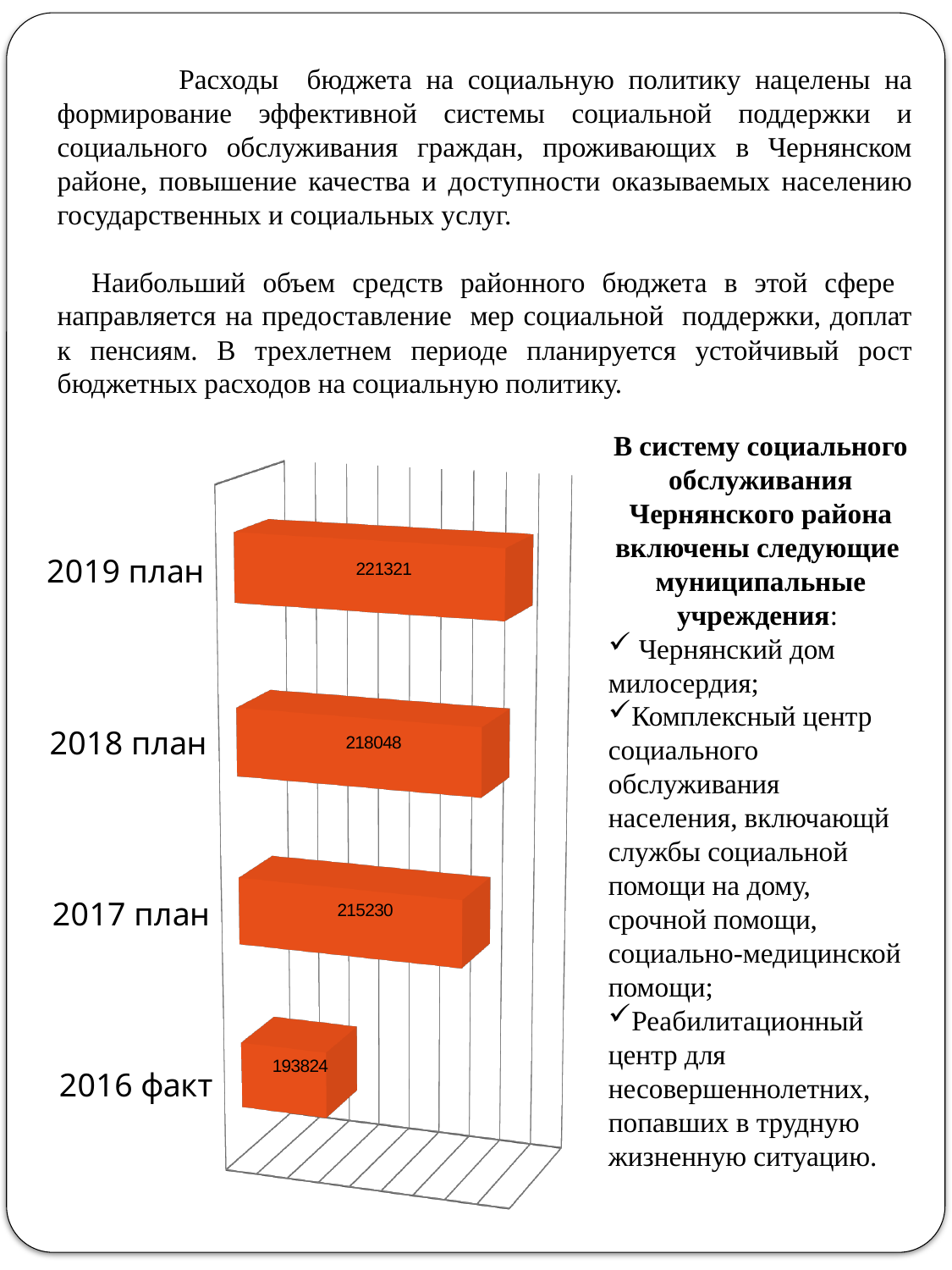
How many categories are shown in the chart? 4 What is the difference between the values for 2018 план and 2017 план? 2818 What is the value shown for 2016 факт? 193824 What is the value shown for 2017 план? 215230 What kind of chart is shown on the slide? Bar chart Which category has the lowest value? 2016 факт What is the value shown for 2018 план? 218048 What is the difference between the values for 2019 план and 2016 факт? 27497 Which is larger, the value for 2017 план or the value for 2016 факт? 2017 план Which category has the highest value? 2019 план Do the values increase or decrease from 2016 факт to 2019 план? Increase What is the value shown for 2019 план? 221321